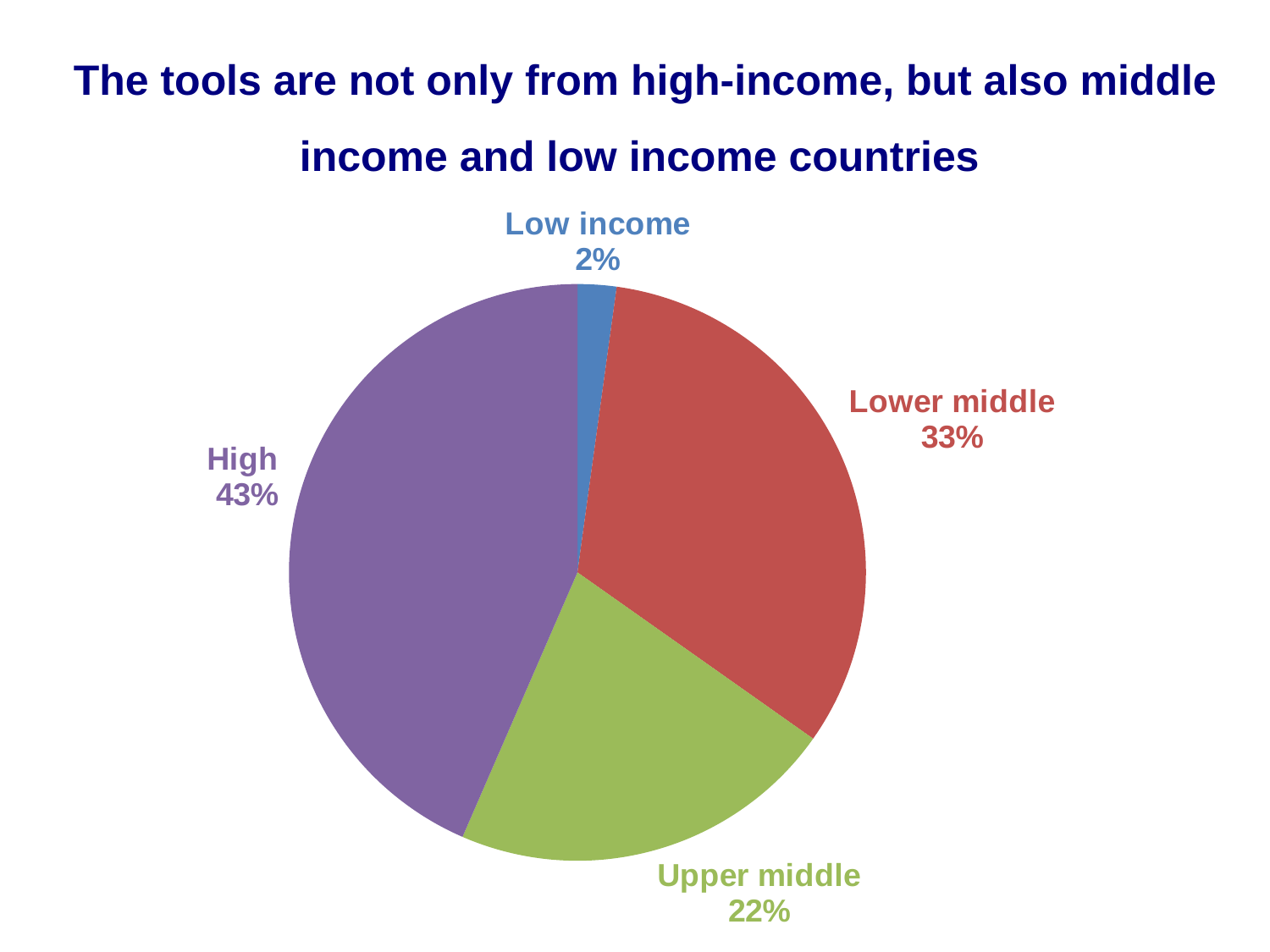
What kind of chart is shown on the slide? Pie chart Which category has the smallest slice of the pie? Low income What is the value shown for Low income? 2% Which is larger, the Lower middle slice or the Upper middle slice? Lower middle Which category has the largest slice of the pie? High What is the value shown for Lower middle? 33% What is the difference between the Upper middle and Low income shares? 20% How many categories are shown in the pie chart? 4 What colour is the High slice of the pie? Purple What share of the pie does the High slice represent? 43% What is the value shown for Upper middle? 22% What is the difference between the High and Lower middle shares? 10%